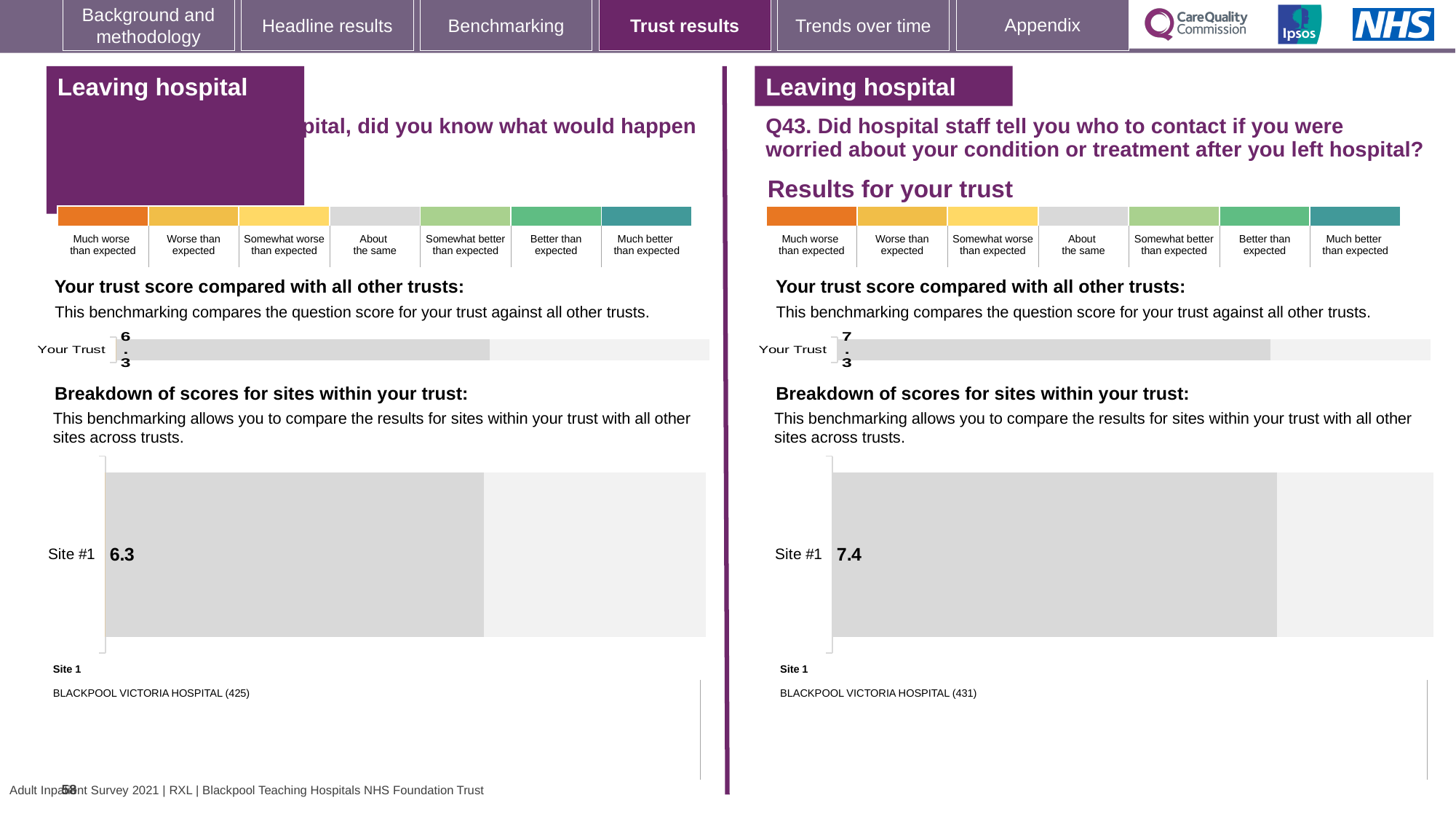
What is the difference between the Site #1 score on the right-hand (Q43) breakdown chart and the Site #1 score on the left-hand breakdown chart? 1.1 On the left-hand 'Breakdown of scores for sites within your trust' chart, what is the score for Site #1? 6.3 What type of chart is used for the 'Breakdown of scores for sites within your trust' on the right-hand side? bar chart Comparing the Site #1 scores on the left-hand and right-hand breakdown charts, which side shows the larger score? right-hand (Q43) On the right-hand (Q43) side, what is the difference between the Site #1 score and the Your Trust score? 0.1 How many sites are plotted on the left-hand 'Breakdown of scores for sites within your trust' chart? 1 On the right-hand (Q43) 'Your trust score compared with all other trusts' chart, what is the score shown for Your Trust? 7.3 On the left-hand 'Your trust score compared with all other trusts' chart, what is the score shown for Your Trust? 6.3 Which question number is shown in the title of the right-hand chart section? Q43 On the right-hand (Q43) 'Breakdown of scores for sites within your trust' chart, what is the score for Site #1? 7.4 How many sites are plotted on the right-hand (Q43) 'Breakdown of scores for sites within your trust' chart? 1 On the right-hand (Q43) side, which hospital is listed as Site 1 below the breakdown chart? BLACKPOOL VICTORIA HOSPITAL (431)